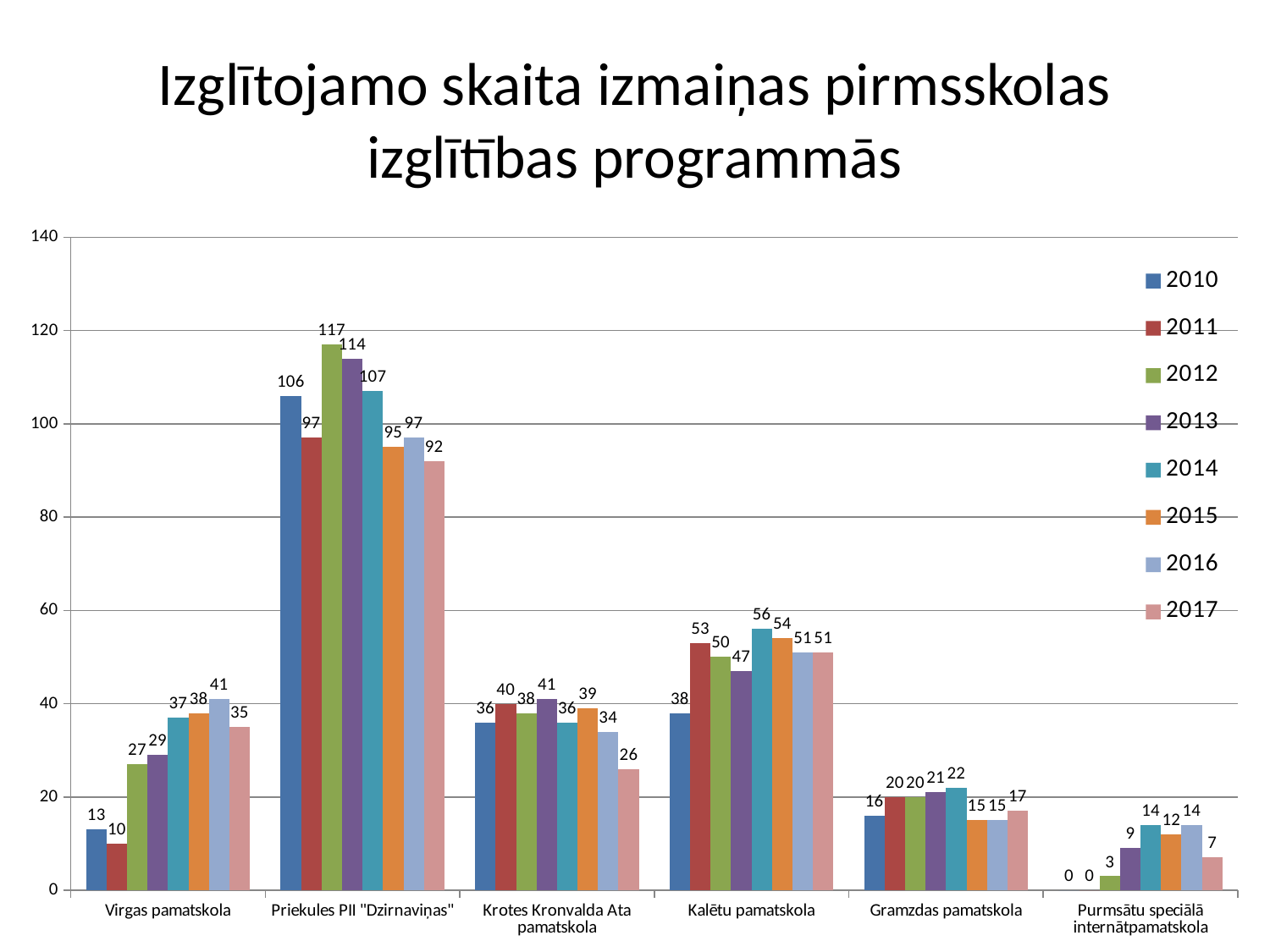
How many categories are shown on the x axis? 6 What is the value for Kalētu pamatskola in 2014? 56 What is the value for Priekules PII "Dzirnaviņas" in 2012? 117 Which is larger for Krotes Kronvalda Ata pamatskola: the 2011 value or the 2017 value? 2011 What is the title of the chart? Izglītojamo skaita izmaiņas pirmsskolas izglītības programmās What is the value for Virgas pamatskola in 2016? 41 What is the value for Purmsātu speciālā internātpamatskola in 2010? 0 Which category has the lowest value in 2013? Purmsātu speciālā internātpamatskola What kind of chart is shown on the slide? Bar chart Which category has the highest value in 2017? Priekules PII "Dzirnaviņas" How many series does the legend list? 8 What is the difference between the 2012 and 2017 values for Priekules PII "Dzirnaviņas"? 25